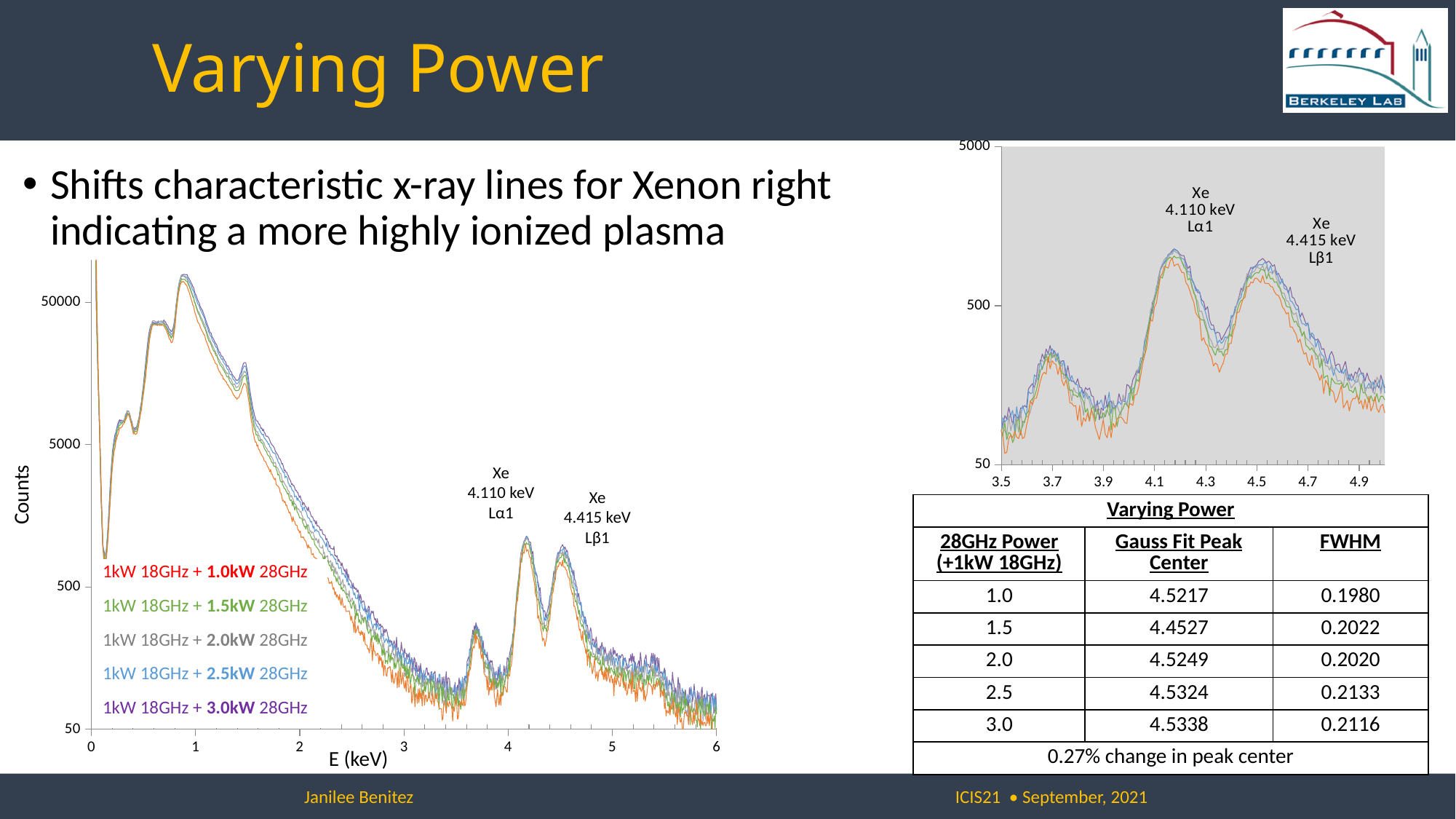
On the large chart on the left, what energy is annotated for the Xe Lα1 line? 4.110 keV On the inset chart at the top right, what is the lowest value labelled on the x axis? 3.5 What kind of chart is the large chart on the left of the slide? Line chart On the inset chart at the top right, are the counts at 3.5 keV greater or less than 500? less On the large chart on the left, what is the highest value labelled on the x axis? 6 On the inset chart at the top right, is the peak near 4.2 keV greater or less than 500 counts? greater On the large chart on the left, is the peak near 4.1 keV greater or less than 500 counts? greater How many data series (power settings) are listed in the legend of the large chart on the left? 5 On the large chart on the left, what energy is annotated for the Xe Lβ1 line? 4.415 keV What is the label of the x axis on the large chart on the left? E (keV) What is the label of the y axis on the large chart on the left? Counts